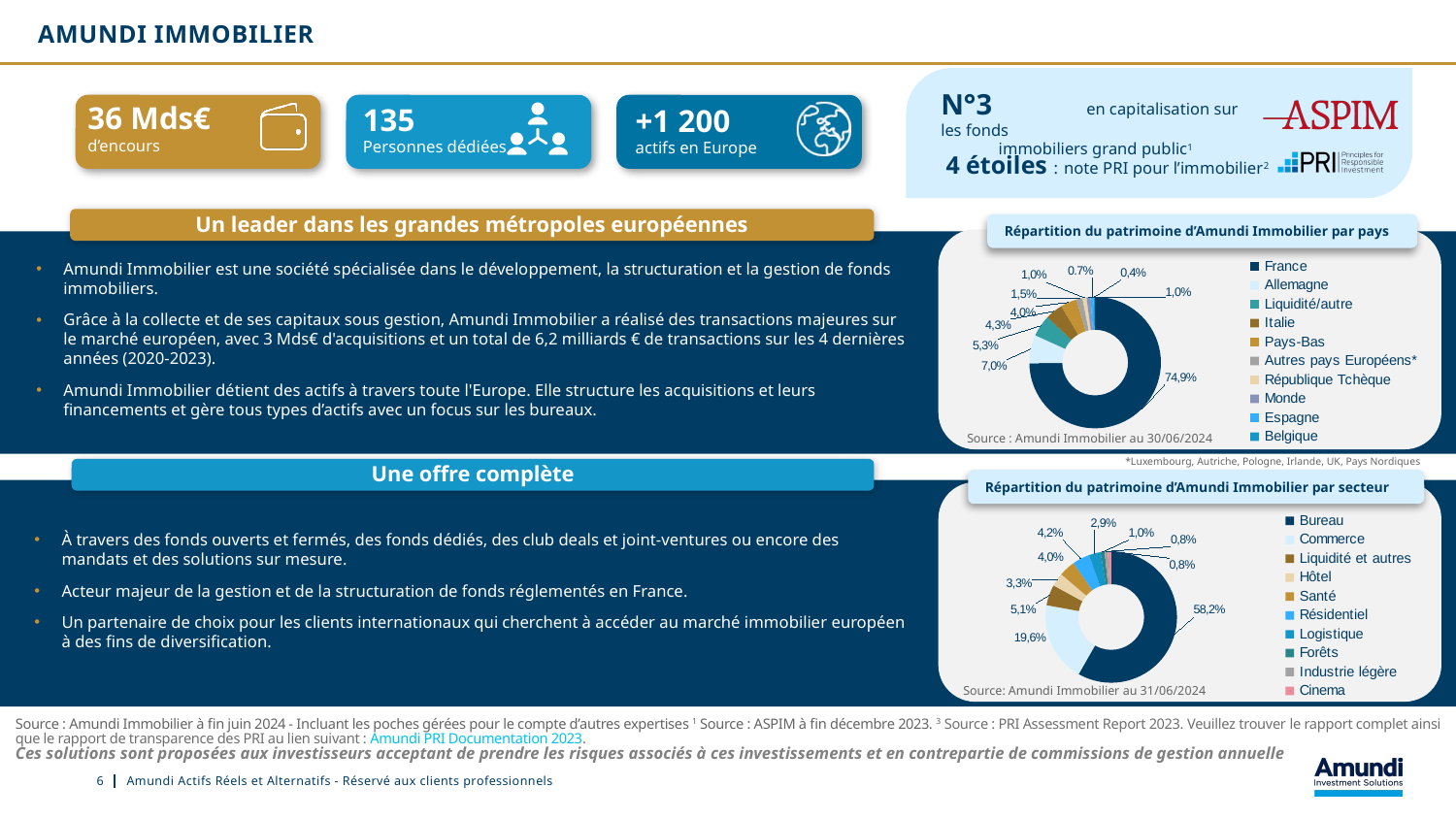
In the chart 'Répartition du patrimoine d'Amundi Immobilier par secteur', what share is shown for Bureau? 58,2% In the chart 'Répartition du patrimoine d'Amundi Immobilier par secteur', what is the difference between the shares of Bureau and Commerce? 38,6% In the chart 'Répartition du patrimoine d'Amundi Immobilier par secteur', which is larger, the share of Bureau or the share of Commerce? Bureau In the chart 'Répartition du patrimoine d'Amundi Immobilier par secteur', what share is shown for Commerce? 19,6% How many sectors does the legend of the chart 'Répartition du patrimoine d'Amundi Immobilier par secteur' list? 10 What kind of chart is 'Répartition du patrimoine d'Amundi Immobilier par pays'? Doughnut (pie) chart How many categories does the legend of the chart 'Répartition du patrimoine d'Amundi Immobilier par pays' list? 10 In the chart 'Répartition du patrimoine d'Amundi Immobilier par secteur', which sector has the largest share? Bureau In the chart 'Répartition du patrimoine d'Amundi Immobilier par pays', which country has the largest share? France What source date is given under the chart 'Répartition du patrimoine d'Amundi Immobilier par pays'? Amundi Immobilier au 30/06/2024 In the chart 'Répartition du patrimoine d'Amundi Immobilier par pays', what is the smallest percentage label shown? 0,4% In the chart 'Répartition du patrimoine d'Amundi Immobilier par pays', what share is shown for France? 74,9%